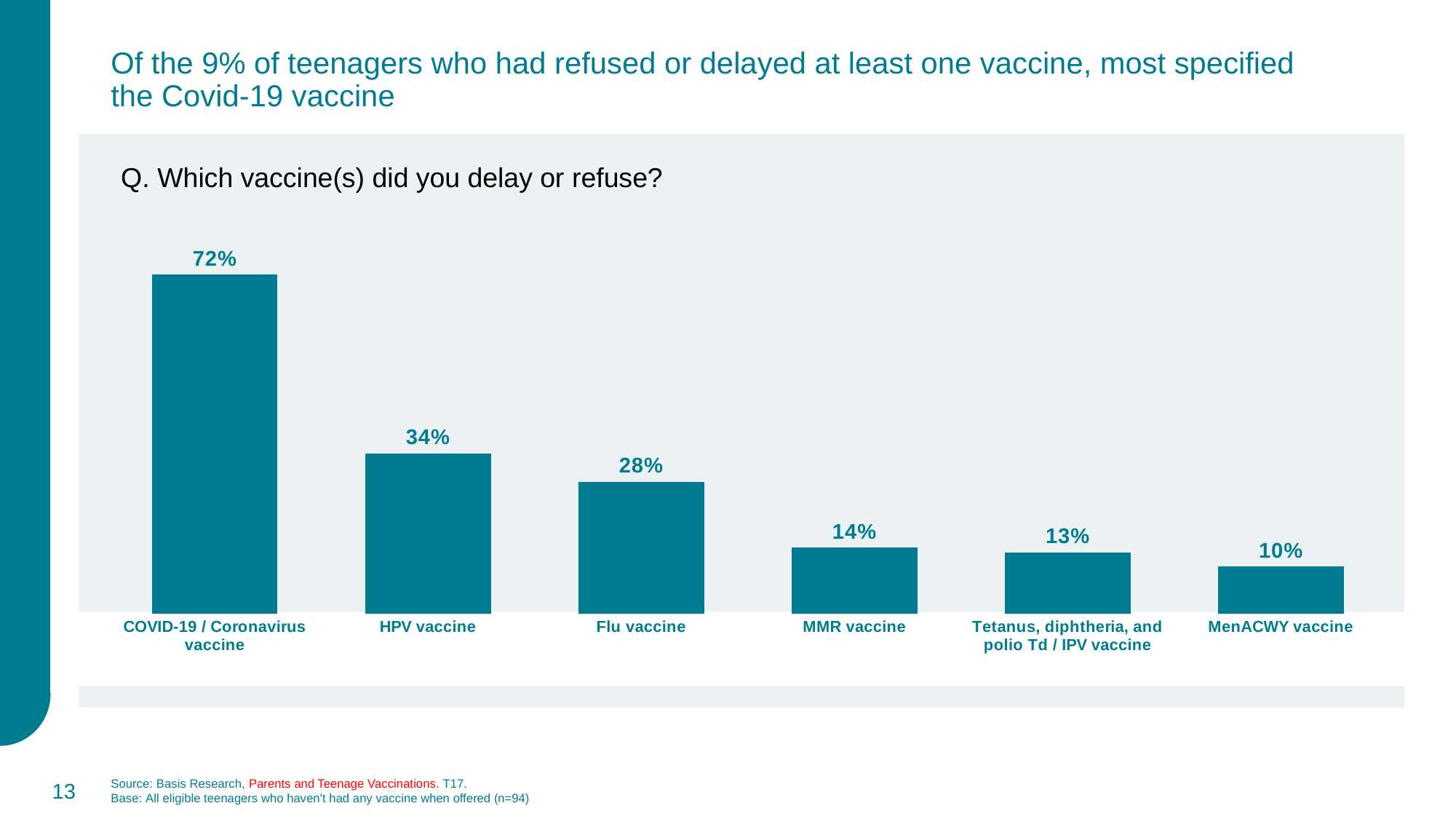
Which vaccine has the lowest percentage in the chart? MenACWY vaccine What is the difference between the percentages for the COVID-19 / Coronavirus vaccine and the HPV vaccine? 38 percentage points How many vaccine categories are shown in the chart? 6 What type of chart is used on this slide? Bar chart What percentage is shown for the MMR vaccine? 14% Which has a higher value, the HPV vaccine or the Flu vaccine? HPV vaccine Which vaccine has the highest percentage of teenagers delaying or refusing it? COVID-19 / Coronavirus vaccine What is the difference between the Flu vaccine and MMR vaccine percentages? 14 percentage points What percentage of teenagers delayed or refused the COVID-19 / Coronavirus vaccine? 72% What question is the chart based on, as shown above the chart? Q. Which vaccine(s) did you delay or refuse? What is the value for the Tetanus, diphtheria, and polio Td / IPV vaccine? 13% What is the value shown for the HPV vaccine? 34%